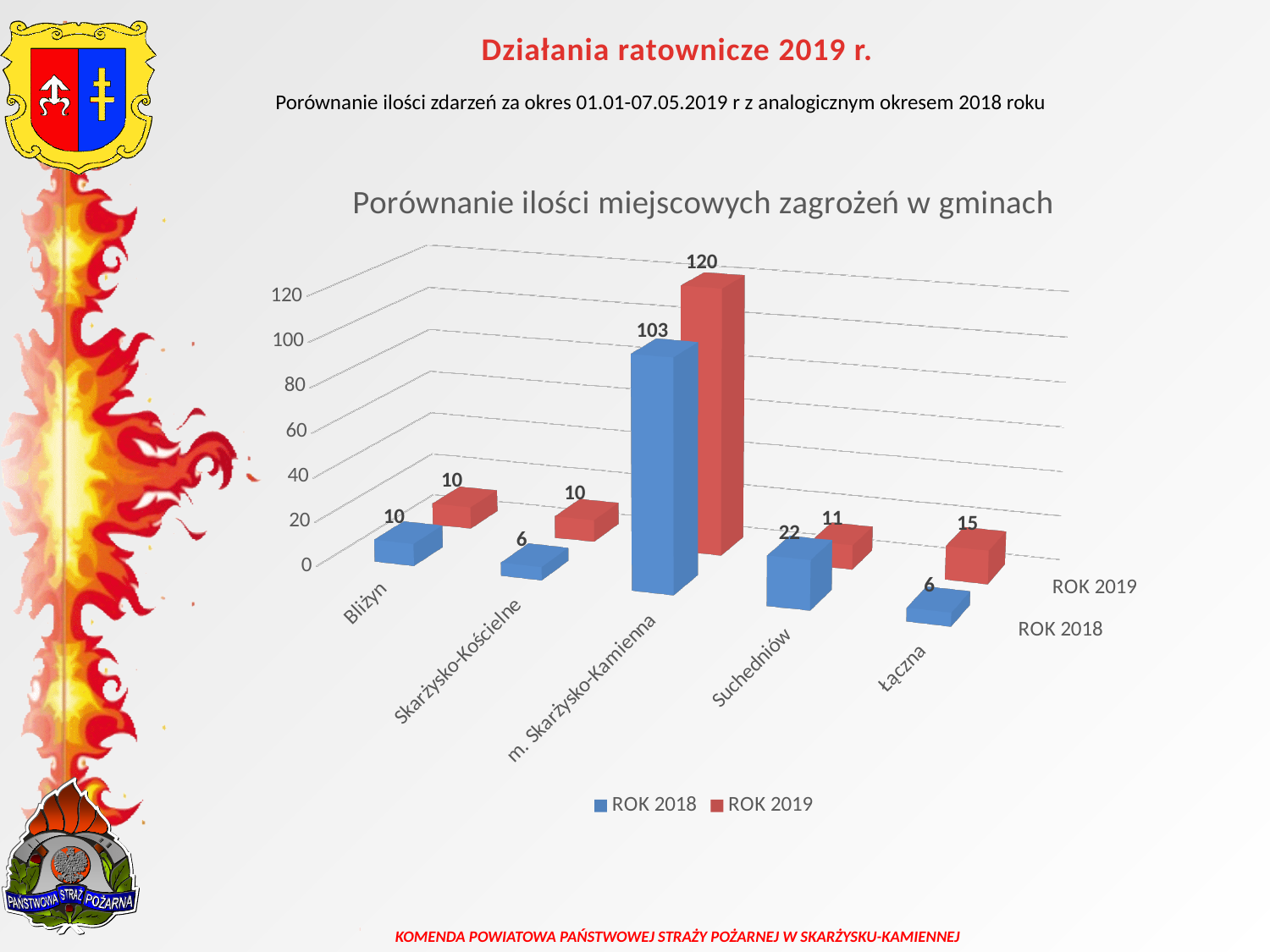
What is the value for Łączna in the ROK 2019 series? 15 Which category has the highest value in the ROK 2019 series? m. Skarżysko-Kamienna What is the value for Skarżysko-Kościelne in the ROK 2018 series? 6 What is the value for m. Skarżysko-Kamienna in the ROK 2019 series? 120 How many series does the legend list? 2 What kind of chart is shown on the slide? bar chart What is the difference between the ROK 2019 and ROK 2018 values for m. Skarżysko-Kamienna? 17 What is the title of the chart? Porównanie ilości miejscowych zagrożeń w gminach Which category has the lowest value in the ROK 2019 series? Bliżyn and Skarżysko-Kościelne (both 10) How many categories (gminy) are shown on the x axis? 5 What is the value for Suchedniów in the ROK 2018 series? 22 For Suchedniów, which series has the larger value, ROK 2018 or ROK 2019? ROK 2018